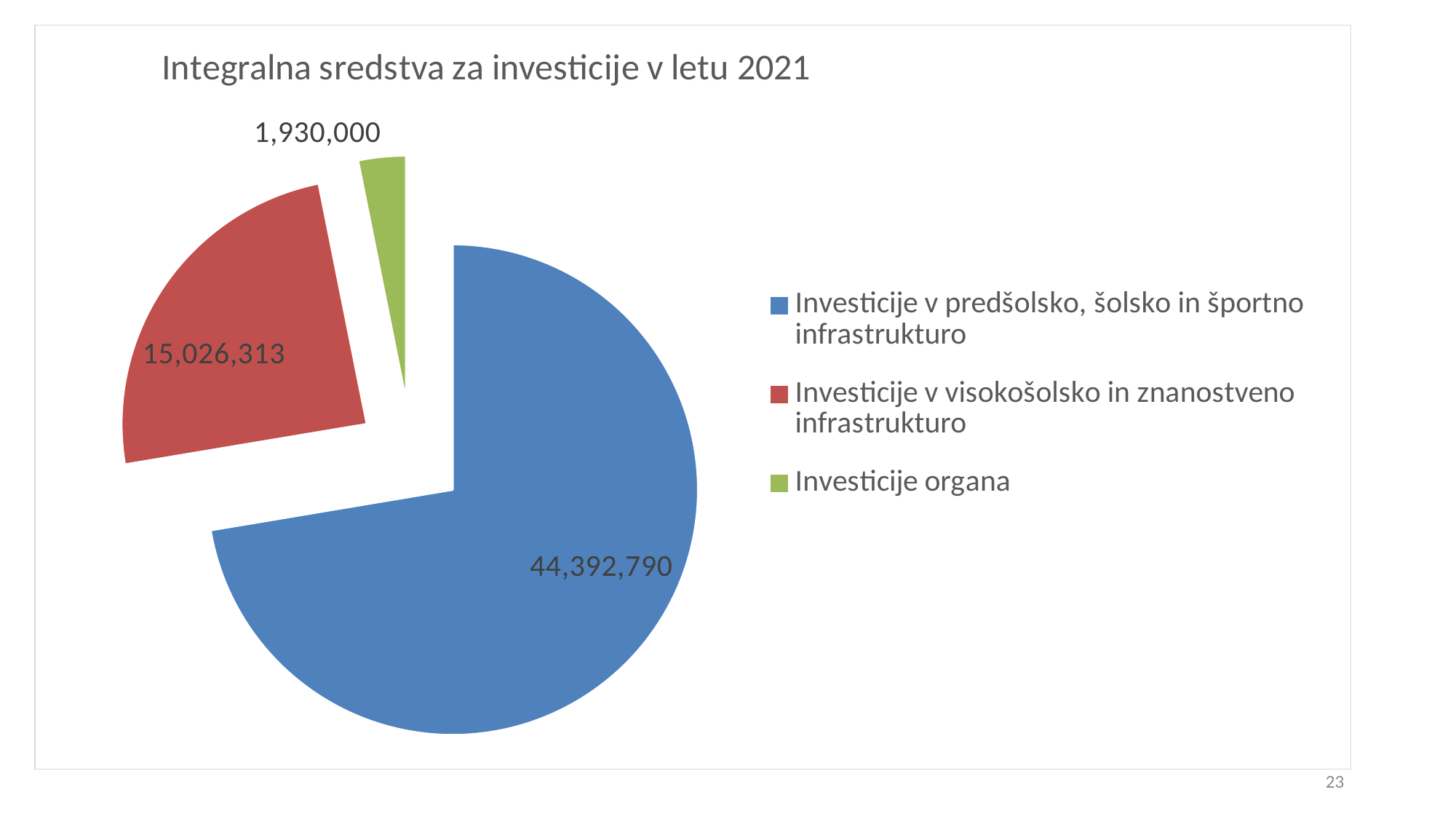
Which category has the largest slice of the pie? Investicije v predšolsko, šolsko in športno infrastrukturo What is the difference between the value for Investicije v visokošolsko in znanostveno infrastrukturo and the value for Investicije organa? 13,096,313 What is the title of the chart? Integralna sredstva za investicije v letu 2021 What is the value for Investicije v predšolsko, šolsko in športno infrastrukturo? 44,392,790 What colour is the slice for Investicije organa? Green Which category has the smallest slice of the pie? Investicije organa What is the value for Investicije v visokošolsko in znanostveno infrastrukturo? 15,026,313 What type of chart is shown on the slide? Pie chart How many categories does the pie chart show? 3 Which is larger: the value for Investicije v visokošolsko in znanostveno infrastrukturo or the value for Investicije organa? Investicije v visokošolsko in znanostveno infrastrukturo What is the difference between the value for Investicije v predšolsko, šolsko in športno infrastrukturo and the value for Investicije v visokošolsko in znanostveno infrastrukturo? 29,366,477 What is the value for Investicije organa? 1,930,000